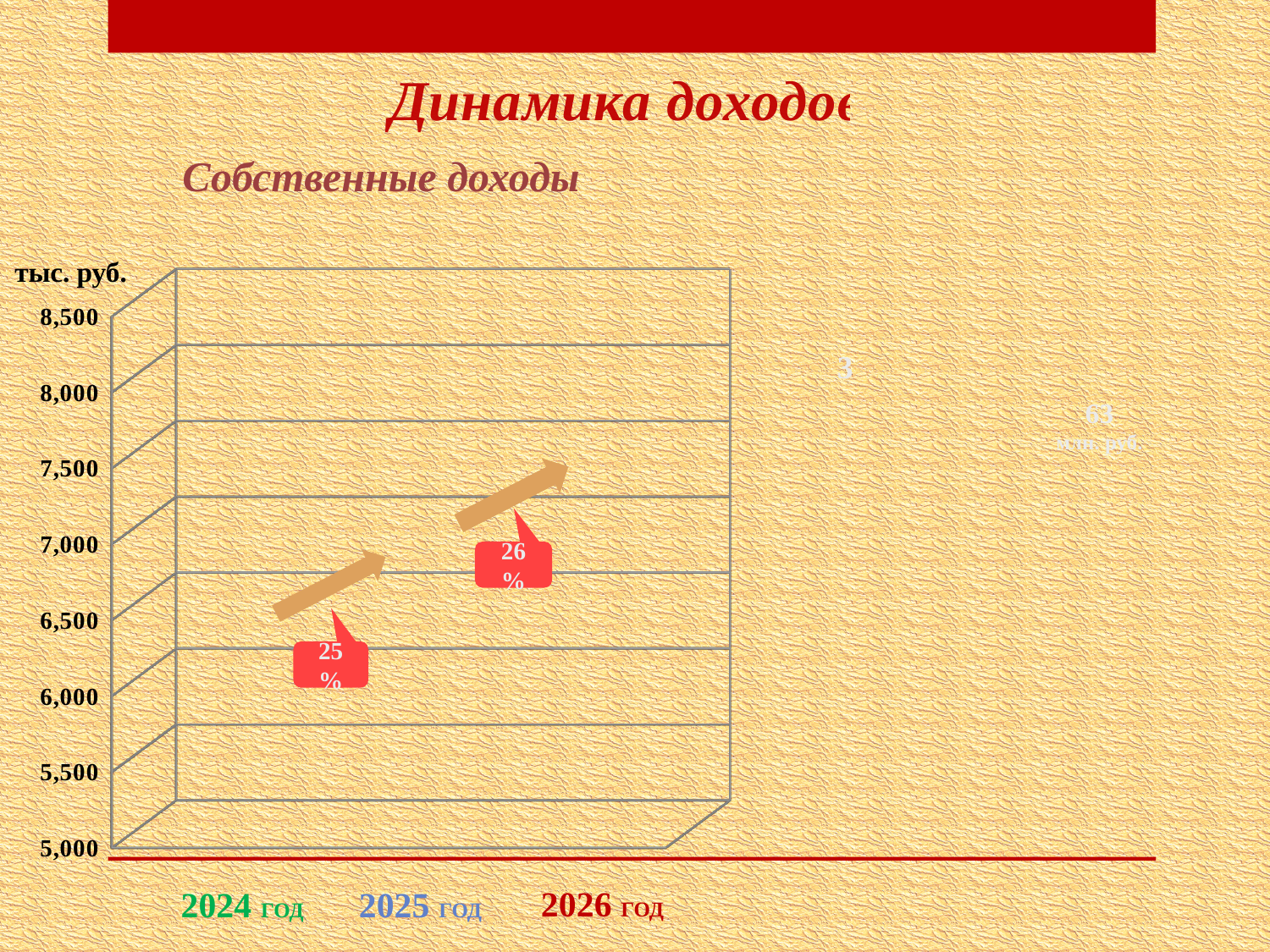
What is the title of the chart on the slide? Собственные доходы Do the arrows on the chart indicate that income rises or falls from 2024 to 2026? rises How many years are labelled along the x axis of the chart? 3 Which callout shows the larger percentage, the first (25%) or the second (26%)? the second (26%) What unit is shown on the vertical axis of the chart? тыс. руб. What percentage is shown in the second callout, between 2025 and 2026? 26% What percentage is shown in the first callout, between 2024 and 2025? 25%